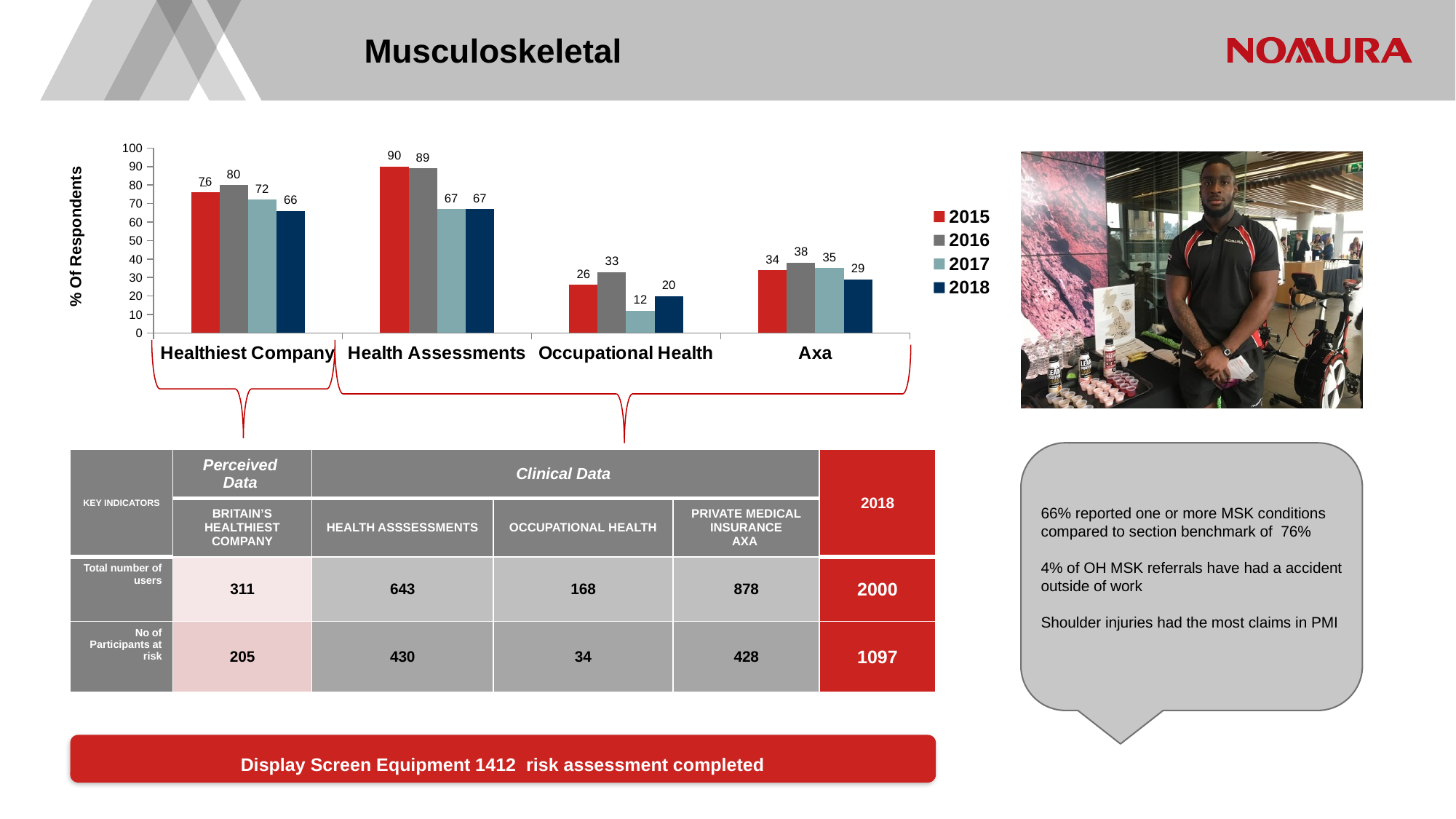
How many categories are shown on the x axis of the chart? 4 How many series does the chart legend list? 4 Which category has the highest value in 2015? Health Assessments What is the value for Healthiest Company in 2018? 66 What is the value for Health Assessments in 2015? 90 Which category has the lowest value in 2017? Occupational Health What is the value for Occupational Health in 2017? 12 What is the value for Axa in 2016? 38 Which is larger for Occupational Health: the 2016 value or the 2018 value? 2016 What kind of chart is shown on the slide? Bar chart What is the label of the chart's y axis? % Of Respondents What is the difference between the 2015 and 2018 values for Health Assessments? 23